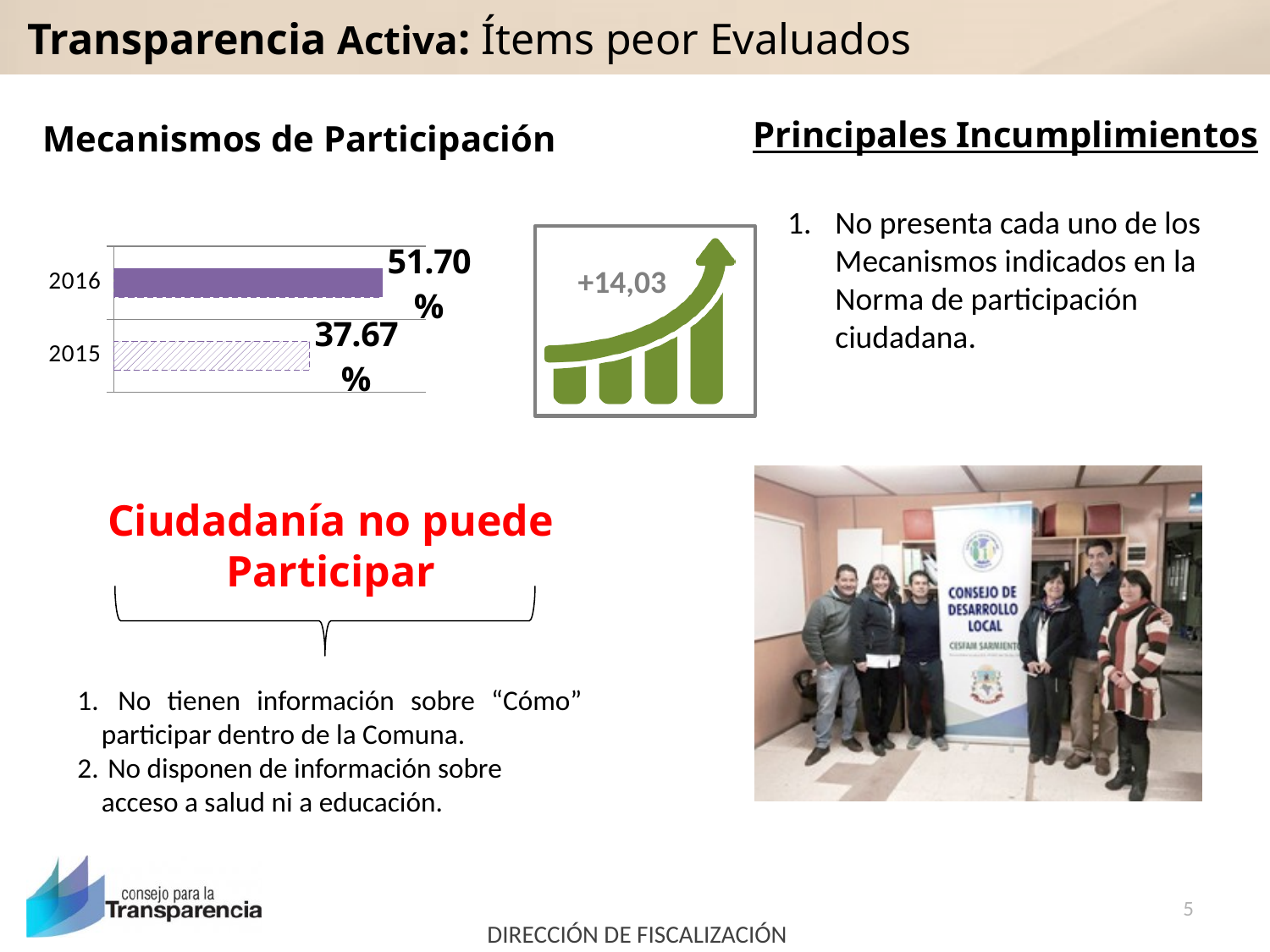
Which bar in the Mecanismos de Participación chart is drawn with a hatched pattern? 2015 Did the Mecanismos de Participación value rise or fall from 2015 to 2016? rise What kind of chart is used for Mecanismos de Participación? bar chart Is the value for 2016 larger or smaller than the value for 2015 in the Mecanismos de Participación chart? larger Which year has the higher value in the Mecanismos de Participación chart? 2016 Which year has the lower value in the Mecanismos de Participación chart? 2015 What is the difference between the 2016 and 2015 values in the Mecanismos de Participación chart? 14.03% How many years are shown in the Mecanismos de Participación chart? 2 What change figure is shown in the green arrow icon next to the Mecanismos de Participación chart? +14,03 What is the value for 2015 in the Mecanismos de Participación chart? 37.67% What is the value for 2016 in the Mecanismos de Participación chart? 51.70%